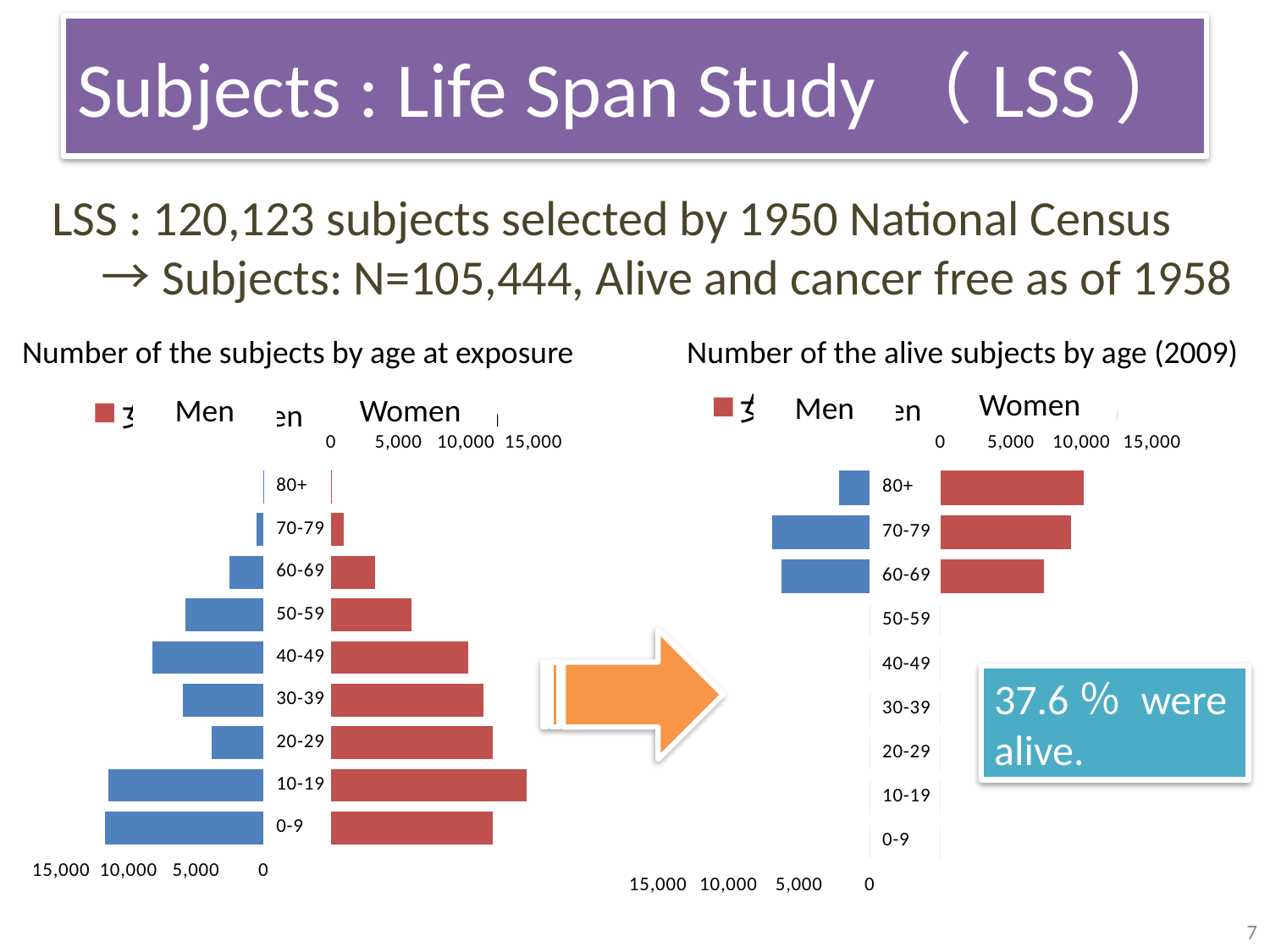
On the left chart, 'Number of the subjects by age at exposure', which age group has the largest number of women? 10-19 On the left chart, 'Number of the subjects by age at exposure', is the number of men aged 40-49 greater or less than 5,000? greater How many age groups are shown on the left chart, 'Number of the subjects by age at exposure'? 9 On the right chart, 'Number of the alive subjects by age (2009)', which age group has the largest number of women? 80+ On the right chart, 'Number of the alive subjects by age (2009)', is the number of men aged 80+ greater or less than 5,000? less On the right chart, 'Number of the alive subjects by age (2009)', which is larger for the 80+ age group: men or women? women On the left chart, 'Number of the subjects by age at exposure', is the number of women aged 10-19 greater or less than 10,000? greater How many series does the legend of the right chart, 'Number of the alive subjects by age (2009)', list? 2 Which colour represents Men on the left chart, 'Number of the subjects by age at exposure'? blue What kind of chart is the left chart, 'Number of the subjects by age at exposure'? bar chart On the left chart, 'Number of the subjects by age at exposure', which is larger: the number of women aged 10-19 or the number of women aged 0-9? women aged 10-19